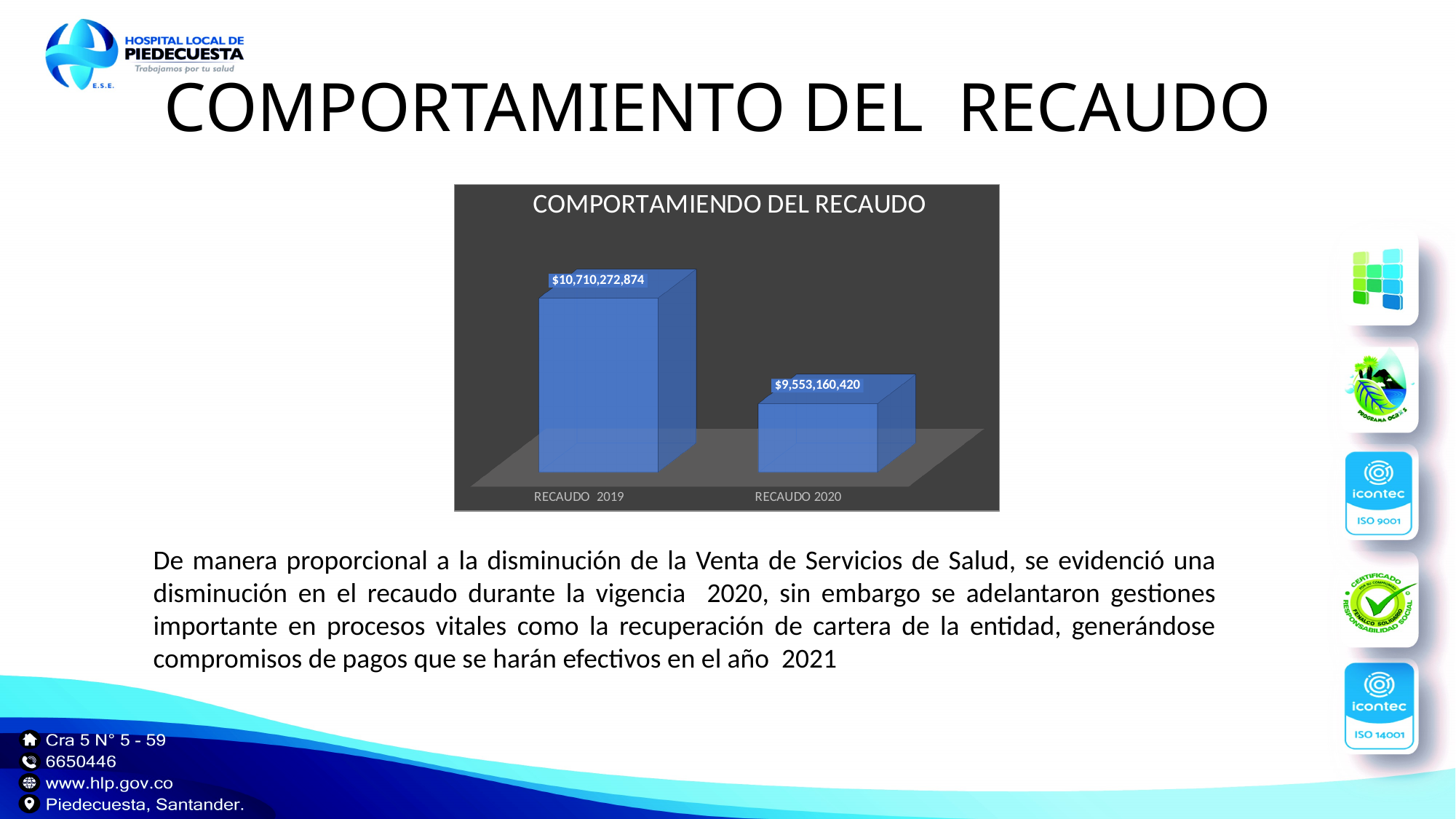
What is the title of the chart? COMPORTAMIENDO DEL RECAUDO What is the value for RECAUDO 2020? $9,553,160,420 What colour are the bars in the chart? Blue What is the value for RECAUDO 2019? $10,710,272,874 Which is larger, the value for RECAUDO 2019 or RECAUDO 2020? RECAUDO 2019 What kind of chart is shown on the slide? Bar chart How many categories are shown in the chart? 2 What is the difference between the values for RECAUDO 2019 and RECAUDO 2020? $1,157,112,454 Do the values rise or fall from RECAUDO 2019 to RECAUDO 2020? Fall Which category has the lowest value? RECAUDO 2020 Which category has the highest value? RECAUDO 2019